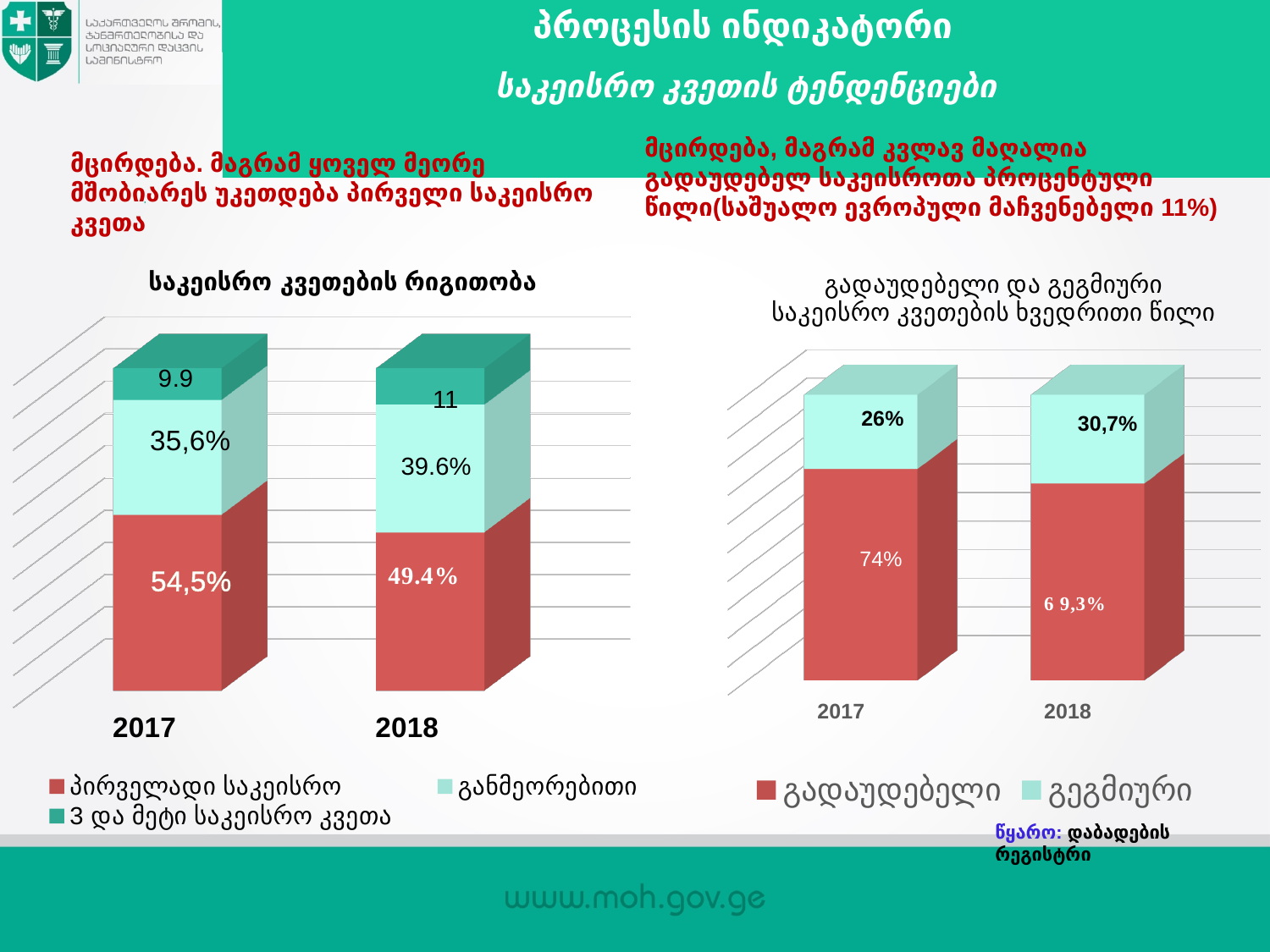
In the left chart, does the value for პირველადი საკეისრო rise or fall from 2017 to 2018? fall In the left chart, how many series does the legend list? 3 In the left chart, what is the value for 3 და მეტი საკეისრო კვეთა in 2017? 9.9 What kind of chart is the right chart? stacked bar chart In the right chart, what is the difference between the გადაუდებელი values for 2017 and 2018? 4,7% How many years are shown on the x axis of the right chart? 2 In the right chart, what is the value for გადაუდებელი in 2017? 74% In the left chart, what is the value for პირველადი საკეისრო in 2017? 54,5% In the left chart, what is the value for პირველადი საკეისრო in 2018? 49.4% In the right chart, what is the value for გეგმიური in 2018? 30,7% In the left chart, what is the value for განმეორებითი in 2018? 39.6% In the right chart, which year has the larger value for გეგმიური, 2017 or 2018? 2018